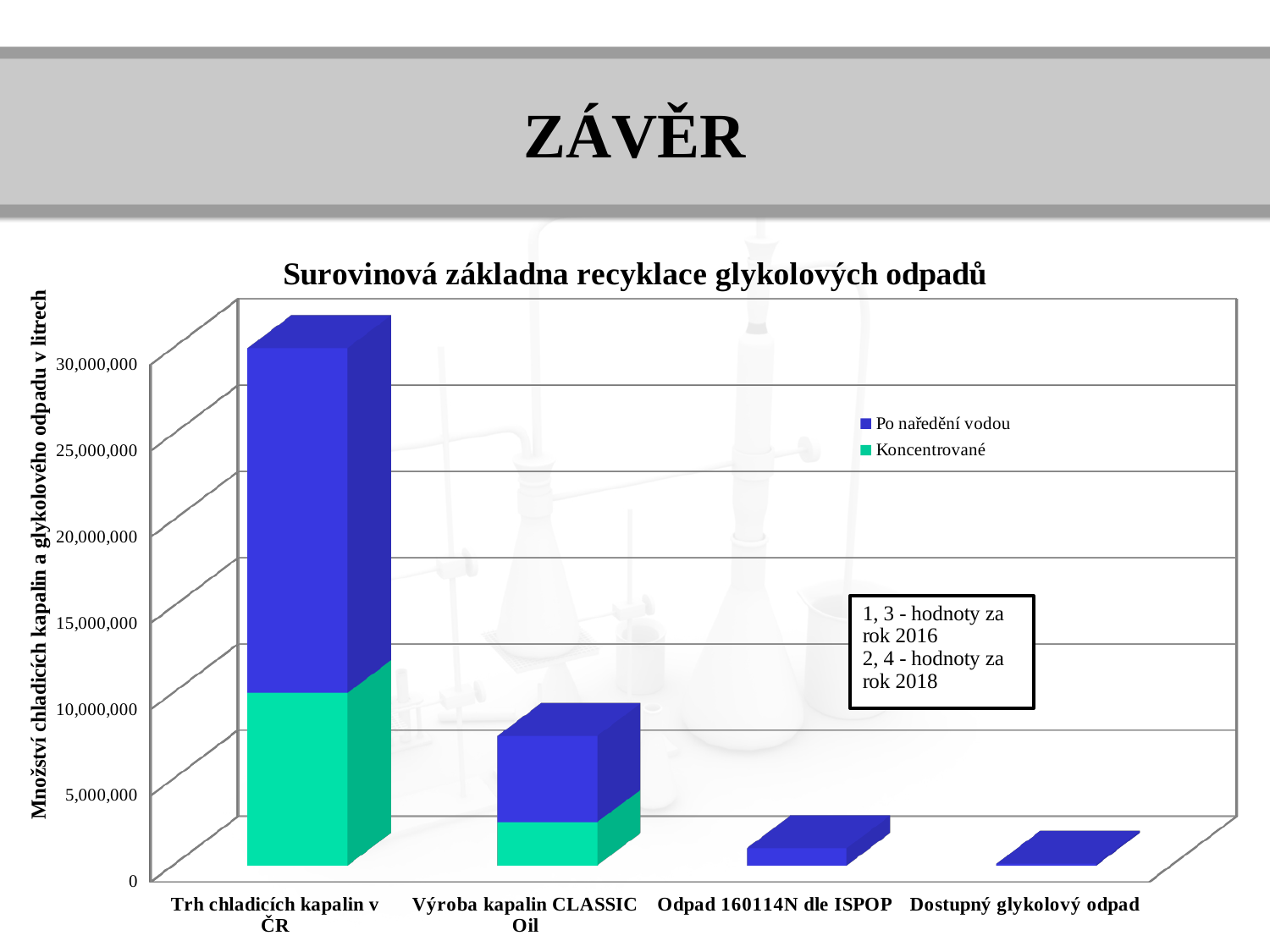
Which category has the highest total value? Trh chladicích kapalin v ČR What is the title of the chart? Surovinová základna recyklace glykolových odpadů Which legend entry is shown in green? Koncentrované Is the total value for Trh chladicích kapalin v ČR greater or less than 25,000,000? greater Is the total value for Výroba kapalin CLASSIC Oil greater or less than 10,000,000? less How many categories are shown on the x axis? 4 Is the value for Odpad 160114N dle ISPOP greater or less than 5,000,000? less Which category has the lowest total value? Dostupný glykolový odpad How many series does the legend list? 2 What kind of chart is shown on the slide? bar chart Which is larger, the total for Výroba kapalin CLASSIC Oil or for Odpad 160114N dle ISPOP? Výroba kapalin CLASSIC Oil Which is larger, the total for Trh chladicích kapalin v ČR or for Výroba kapalin CLASSIC Oil? Trh chladicích kapalin v ČR